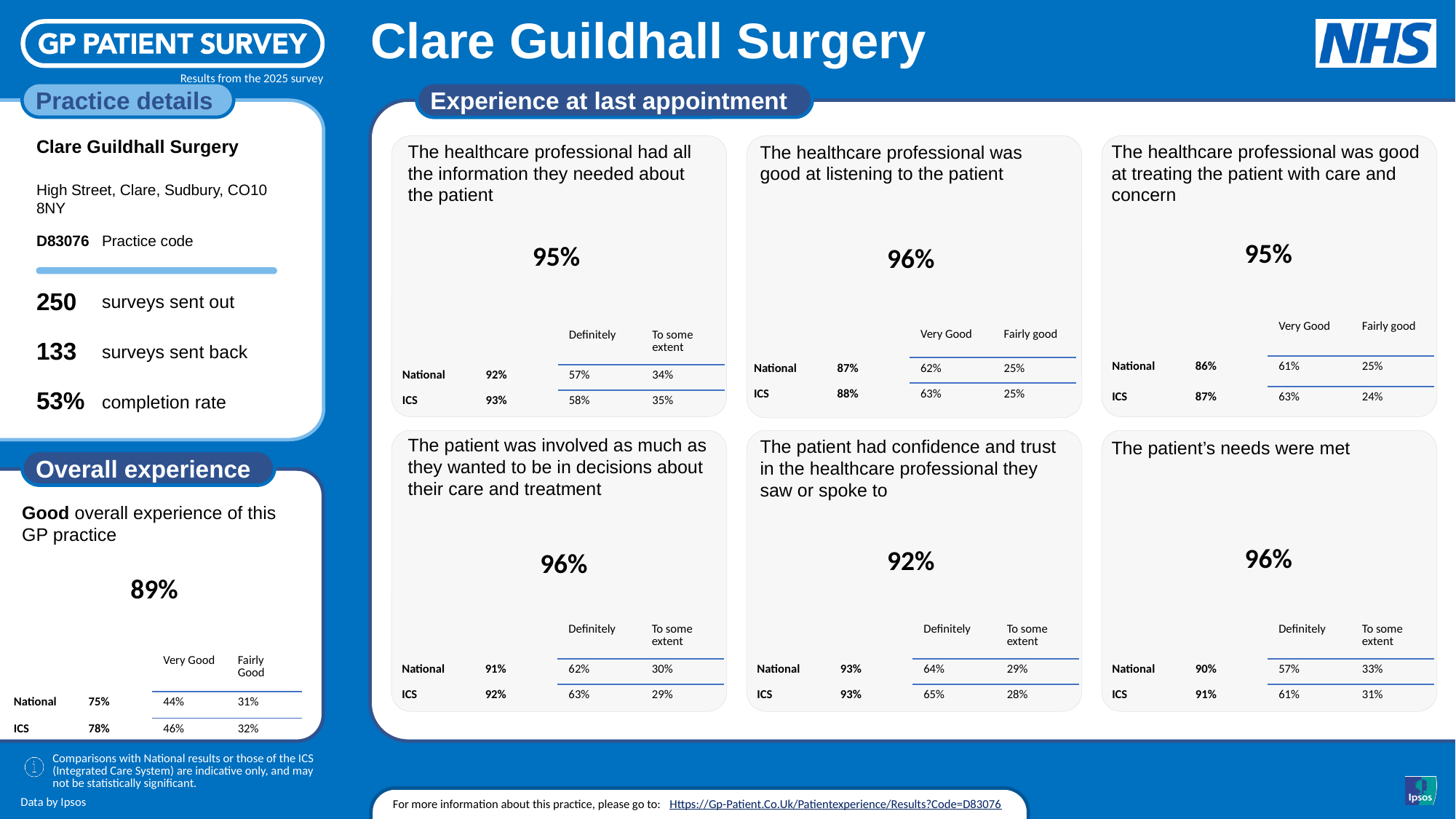
In the 'Overall experience' panel, what is the ICS 'Very Good' value? 46% In the 'Overall experience' panel, what percentage of patients reported a good overall experience of this GP practice? 89% Among the six 'Experience at last appointment' panels, which has the lowest practice headline percentage? The patient had confidence and trust in the healthcare professional they saw or spoke to How many panels are shown under the 'Experience at last appointment' heading? 6 In the 'The healthcare professional was good at listening to the patient' panel, what is the practice's headline percentage? 96% In the 'The healthcare professional was good at treating the patient with care and concern' panel, what are the two response categories shown in the table? Very Good and Fairly good In the 'Overall experience' panel, which is larger: the National value or the ICS value? ICS In the 'The healthcare professional had all the information they needed about the patient' panel, what is the difference between the practice's headline percentage (95%) and the National value (92%)? 3% In the 'The patient's needs were met' panel, what is the ICS 'Definitely' value? 61% In the 'The patient had confidence and trust in the healthcare professional they saw or spoke to' panel, what is the practice's headline percentage? 92% In the 'Overall experience' panel, what is the National value for good overall experience? 75% In the 'The healthcare professional was good at listening to the patient' panel, what is the National 'Very Good' value? 62%